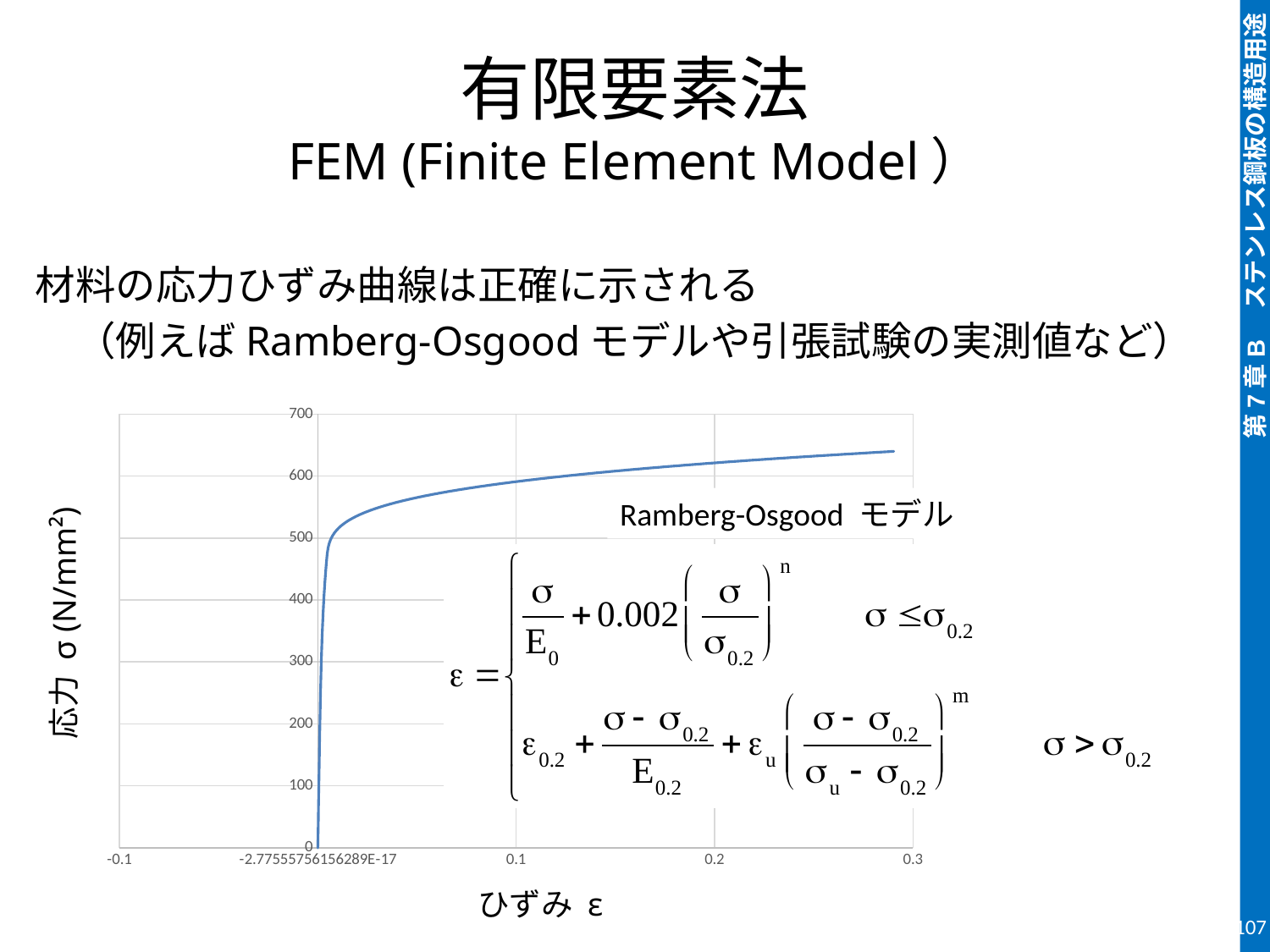
Is the highest stress value plotted on the curve greater or less than 700? less What is the maximum value shown on the vertical axis? 700 Is the stress value at the right end of the curve (near strain 0.29) greater or less than 600? greater What is the label of the horizontal axis? ひずみ ε What is the label of the vertical axis? 応力 σ (N/mm²) What is the maximum value shown on the horizontal axis? 0.3 How many lines (series) are plotted on the chart? 1 Is the stress value at a strain of 0.2 greater or less than 500? greater What kind of chart is shown on the slide? line chart Does the stress value rise or fall as strain increases along the x axis? rise